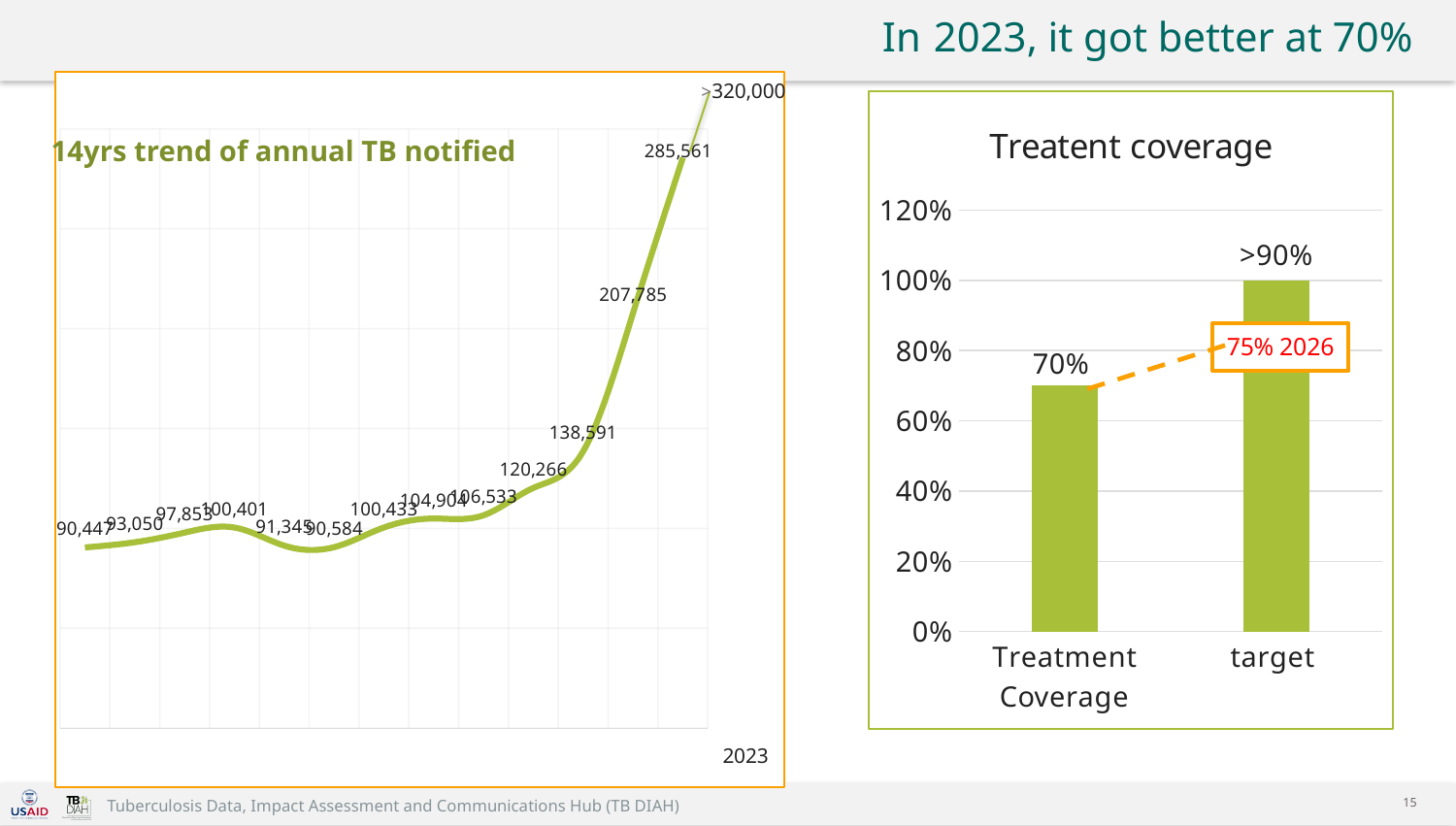
In the '14yrs trend of annual TB notified' chart, what is the lowest labelled value? 90,447 How many data points are plotted in the '14yrs trend of annual TB notified' chart? 14 In the 'Treatent coverage' chart, what is the value for Treatment Coverage? 70% In the '14yrs trend of annual TB notified' chart, what is the value labelled at the final point, for 2023? >320,000 What kind of chart is the right chart titled 'Treatent coverage'? bar chart In the 'Treatent coverage' chart, which bar is taller, Treatment Coverage or target? target In the 'Treatent coverage' chart, is the value for Treatment Coverage greater or less than 80%? less What kind of chart is the left chart titled '14yrs trend of annual TB notified'? line chart How many bars are plotted in the 'Treatent coverage' chart? 2 In the '14yrs trend of annual TB notified' chart, do the values overall rise or fall from left to right? rise In the 'Treatent coverage' chart, what is the value shown for target? >90% In the '14yrs trend of annual TB notified' chart, what is the difference between the points labelled 285,561 and 207,785? 77,776